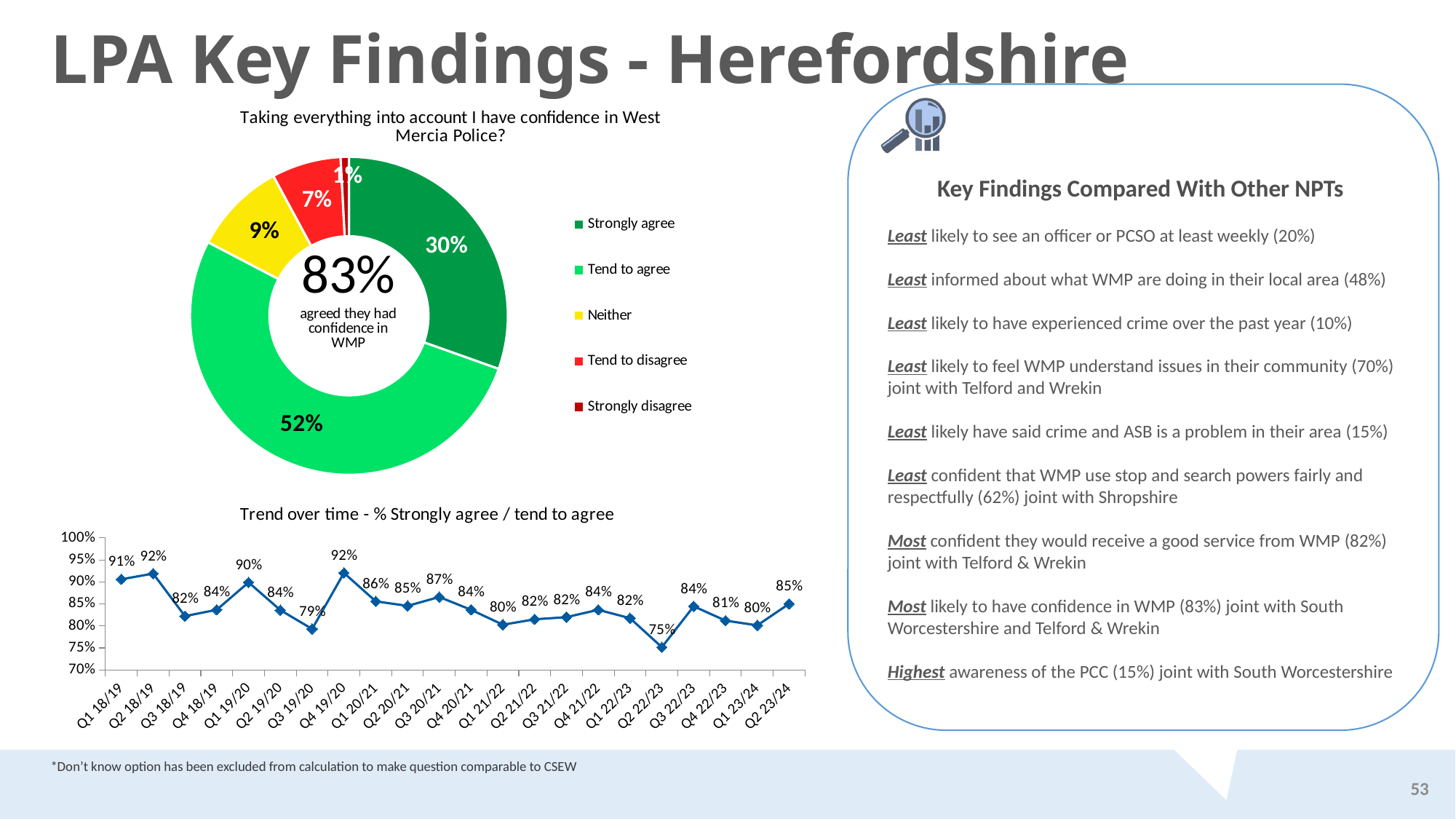
In the trend over time chart, what is the difference between the values for Q1 18/19 and Q3 18/19? 9% In the trend over time chart, what is the value for Q2 23/24? 85% In the confidence donut chart, which response category has the largest share? Tend to agree In the trend over time chart, which quarter has the lowest value? Q2 22/23 In the confidence donut chart, which is larger: 'Neither' or 'Tend to disagree'? Neither In the confidence donut chart, what percentage of respondents said they 'Strongly agree'? 30% In the confidence donut chart, what percentage of respondents said they 'Tend to agree'? 52% How many quarters are plotted in the trend over time chart? 22 In the confidence donut chart, what is the difference between the 'Tend to agree' and 'Strongly agree' shares? 22% What type of chart is the 'Trend over time - % Strongly agree / tend to agree' chart? Line chart In the trend over time chart, what is the value for Q2 22/23? 75% How many entries does the legend of the confidence donut chart list? 5